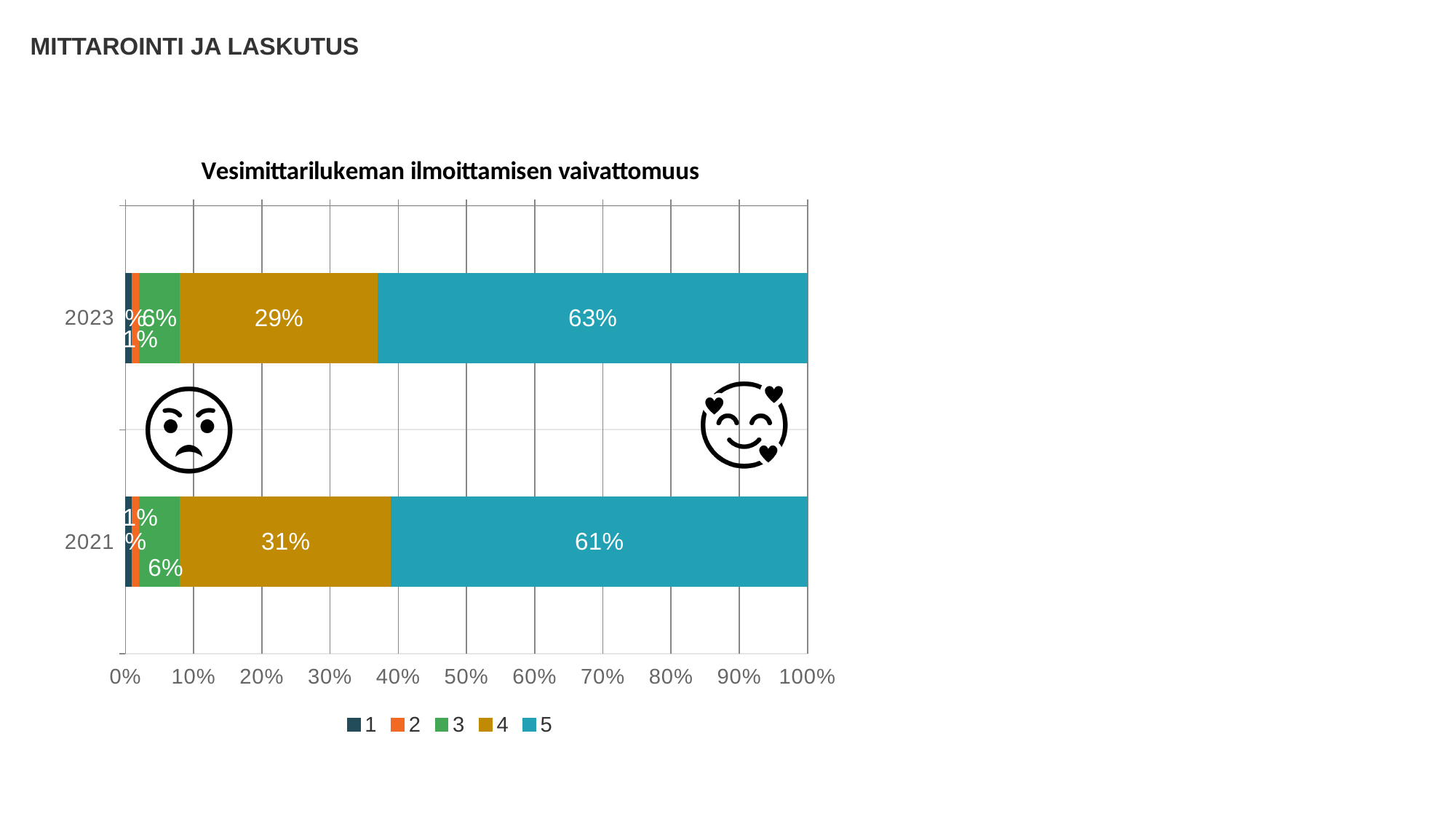
How many series does the legend list? 5 What is the value for series 4 in 2023? 29% Which year has the larger value for series 4, 2021 or 2023? 2021 What is the difference between the series 5 value in 2023 and in 2021? 2 percentage points What is the title of the chart? Vesimittarilukeman ilmoittamisen vaivattomuus What is the value for series 5 in 2023? 63% Which series has the largest share in the 2023 bar? 5 What is the value for series 5 in 2021? 61% What is the value for series 3 in 2023? 6% What kind of chart is shown on the slide? Stacked bar chart How many years (categories) are plotted on the chart? 2 What is the value for series 4 in 2021? 31%